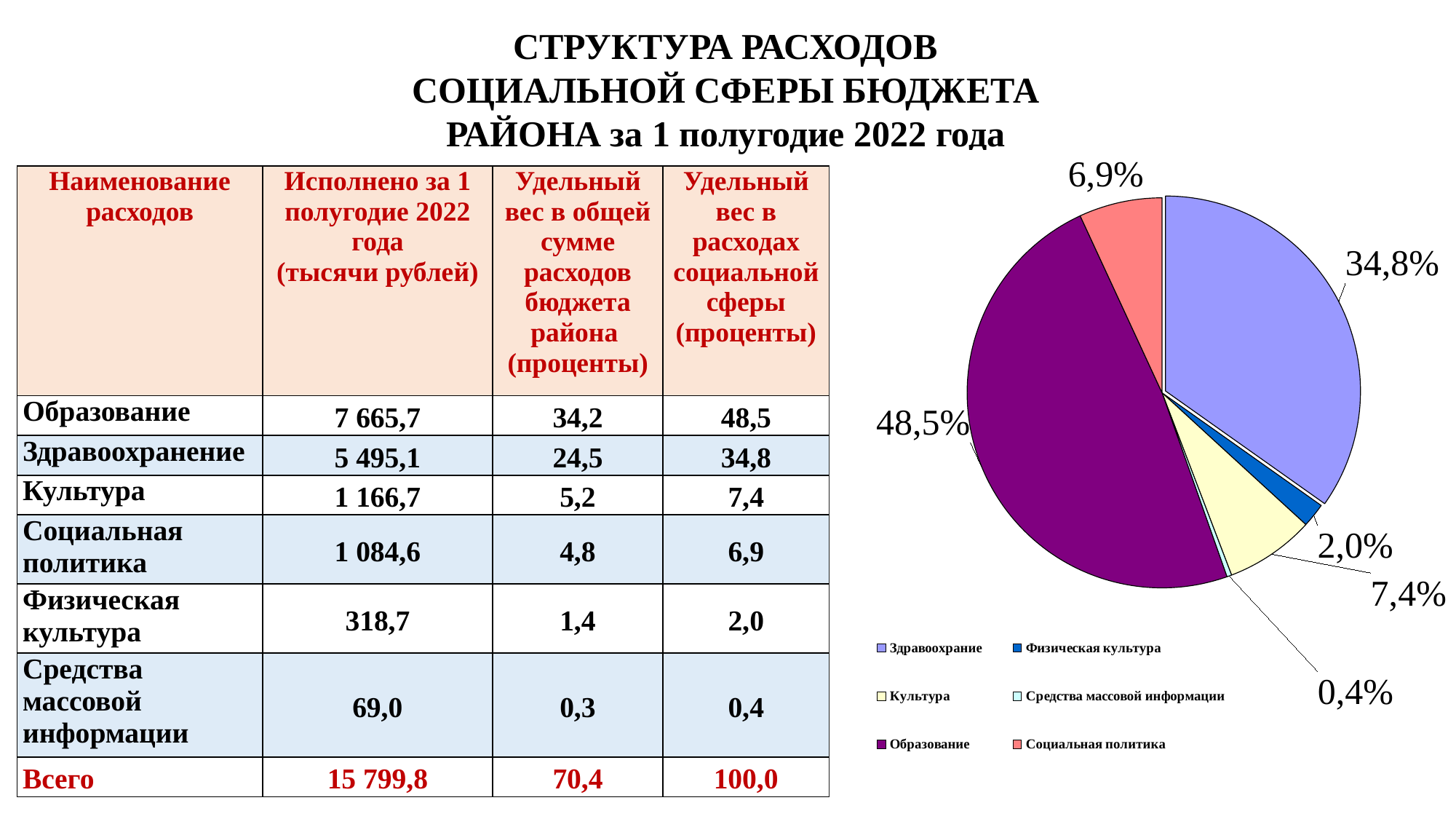
Which slice is larger in the pie chart, Культура or Социальная политика? Культура What share of the pie chart does Здравоохранение have? 34,8% Which category has the largest slice of the pie chart? Образование What share of the pie chart does Культура have? 7,4% What kind of chart is shown on the slide? pie chart What share of the pie chart does Средства массовой информации have? 0,4% What share of the pie chart does Образование have? 48,5% What is the difference in percentage points between the Образование and Здравоохранение slices? 13,7 What share of the pie chart does Социальная политика have? 6,9% What share of the pie chart does Физическая культура have? 2,0% How many categories does the pie chart's legend list? 6 Which category has the smallest slice of the pie chart? Средства массовой информации